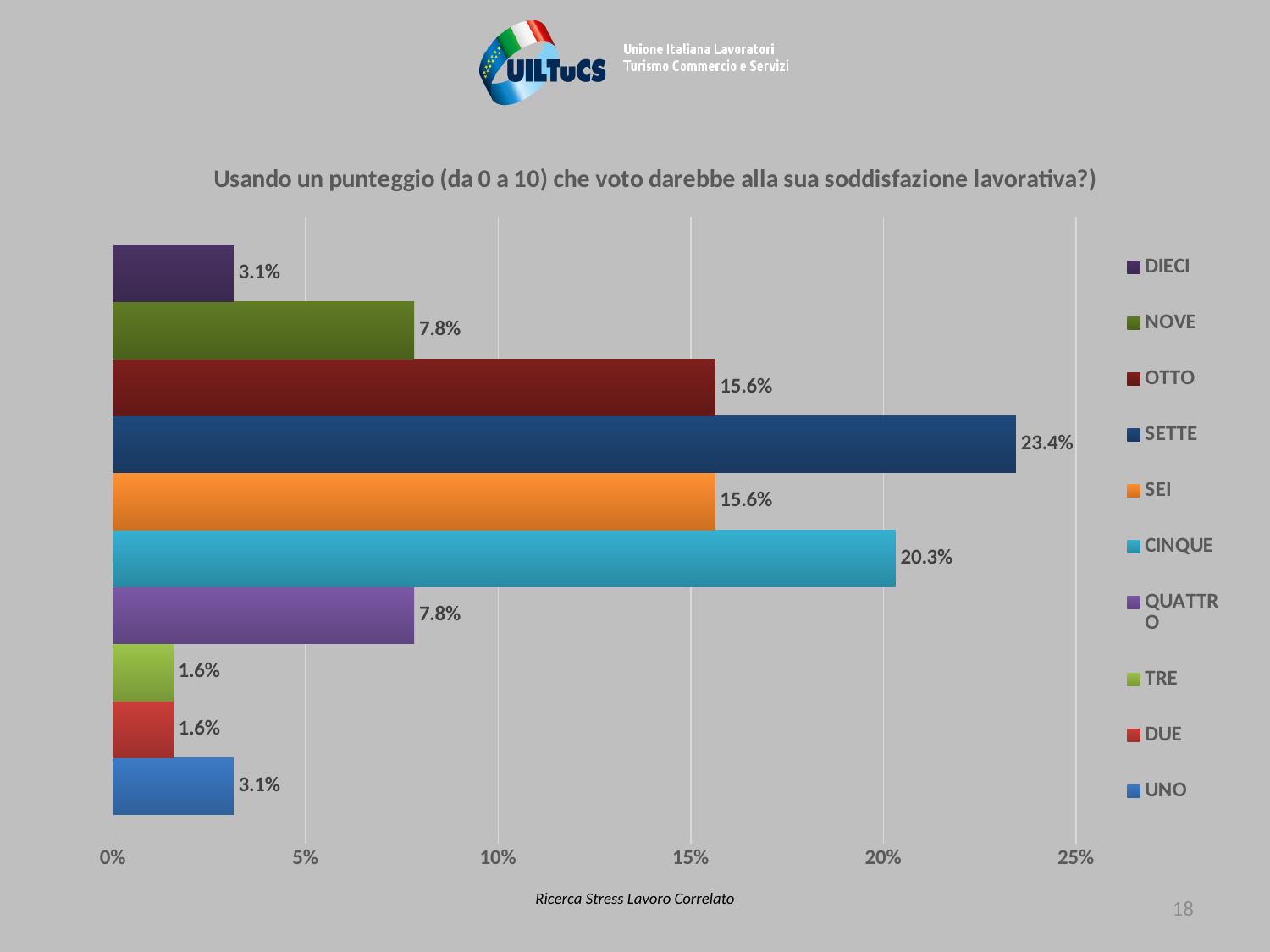
What is the value for DIECI? 3.1% What is the value for CINQUE? 20.3% Which is larger, the value for CINQUE or the value for SEI? CINQUE What is the difference between the values for SETTE and CINQUE? 3.1% What kind of chart is shown on the slide? Bar chart What is the value for OTTO? 15.6% How many bars are plotted in the chart? 10 How many entries does the legend list? 10 What is the difference between the values for NOVE and DIECI? 4.7% What is the value for SETTE? 23.4% Is the value for SETTE greater or less than 20%? greater Which category has the highest value? SETTE